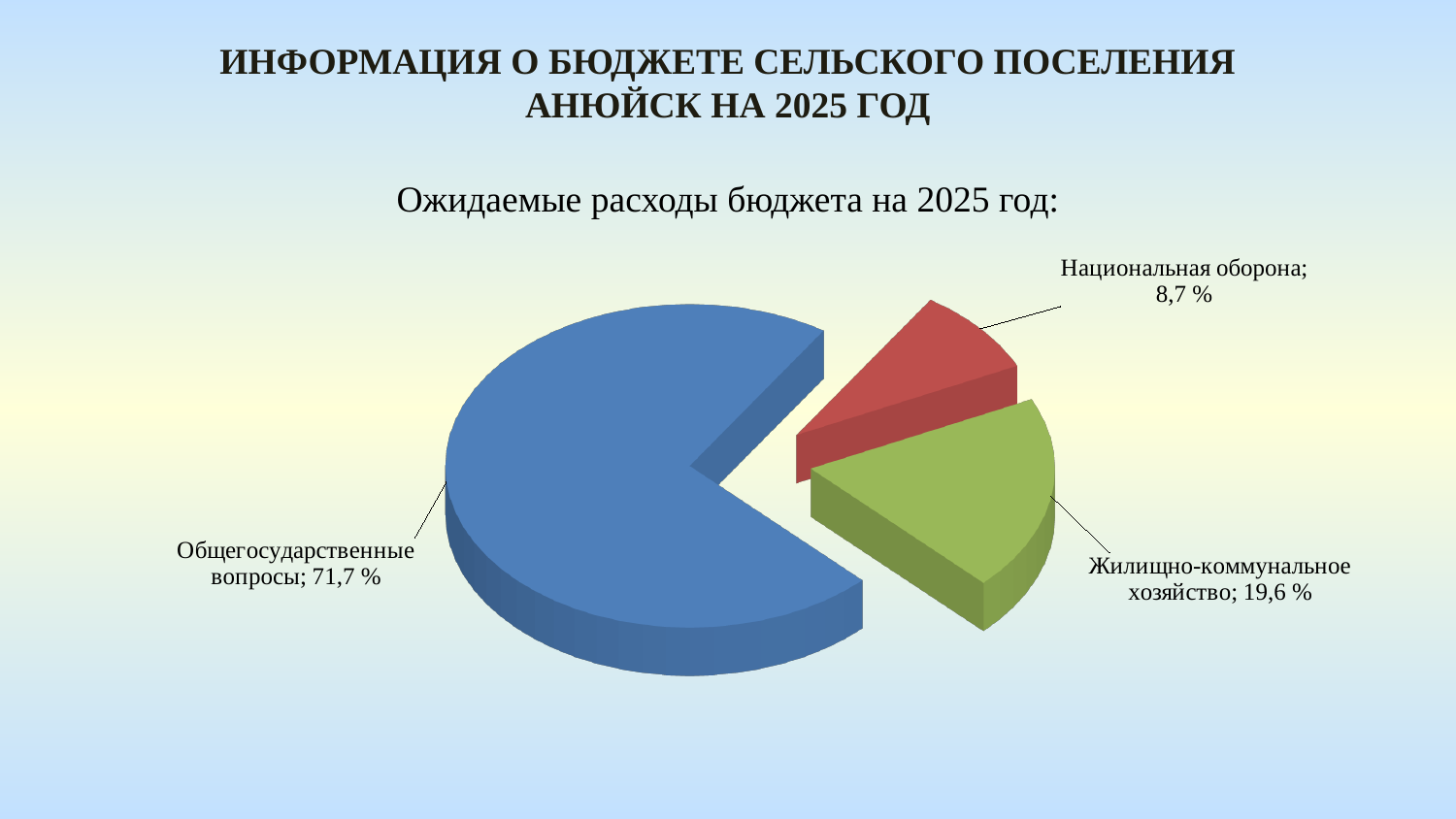
Which expenditure category has the largest share of the pie? Общегосударственные вопросы Which is larger: the share for Жилищно-коммунальное хозяйство or the share for Национальная оборона? Жилищно-коммунальное хозяйство What is the difference in percentage points between Жилищно-коммунальное хозяйство and Национальная оборона? 10,9 What colour is the slice for Общегосударственные вопросы? Blue What kind of chart is shown on the slide? Pie chart Which expenditure category has the smallest share of the pie? Национальная оборона What share of expected 2025 budget expenditures goes to Национальная оборона? 8,7 % What is the subtitle above the chart? Ожидаемые расходы бюджета на 2025 год: What share of expected 2025 budget expenditures goes to Жилищно-коммунальное хозяйство? 19,6 % What is the difference in percentage points between Общегосударственные вопросы and Жилищно-коммунальное хозяйство? 52,1 What share of expected 2025 budget expenditures goes to Общегосударственные вопросы? 71,7 % How many expenditure categories are shown in the pie chart? 3